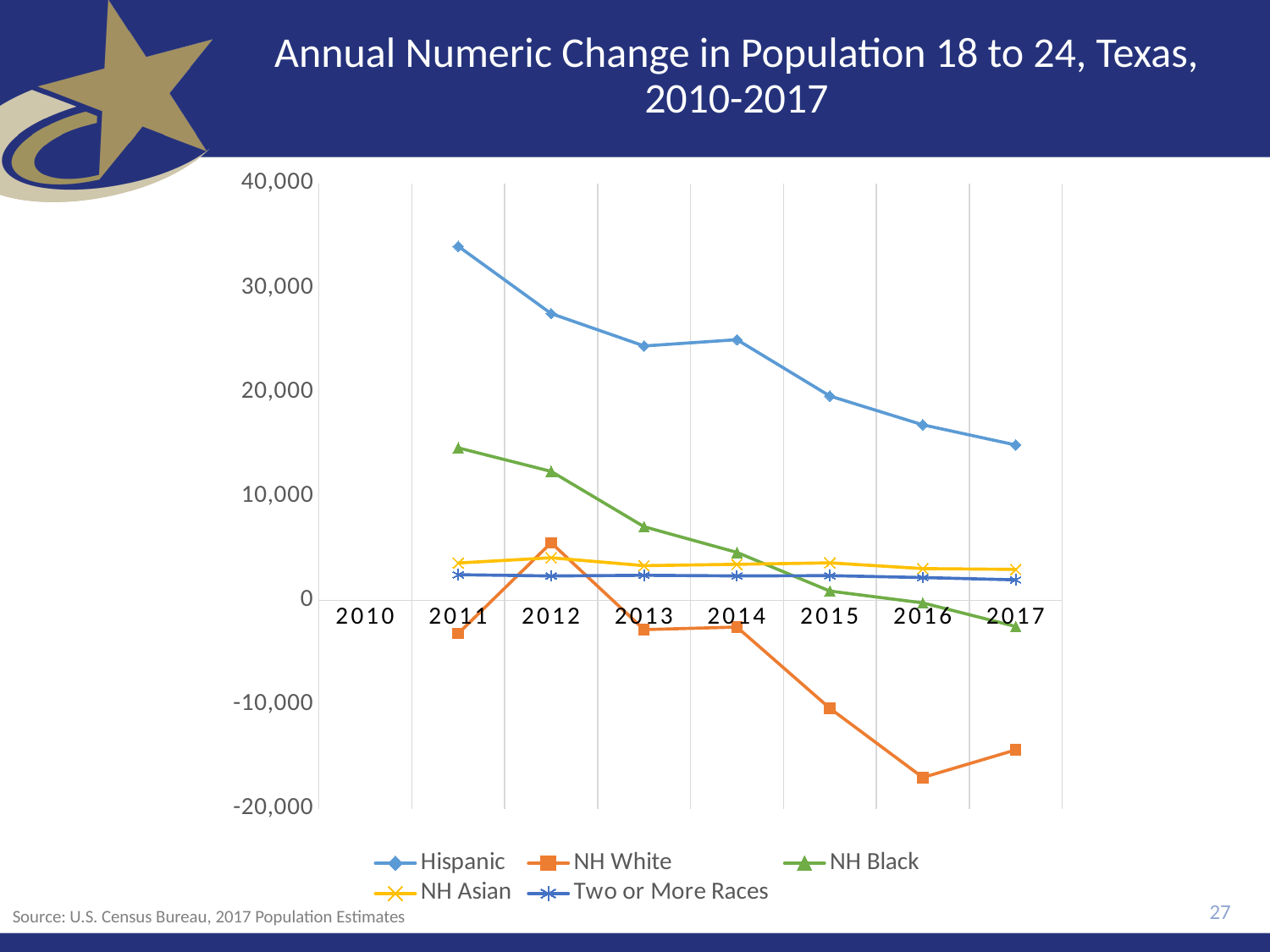
Is the value for NH Black in 2011 greater or less than 10,000? greater What kind of chart is shown on the slide? line chart How many year labels appear along the x axis? 8 Is the value for Hispanic in 2011 greater or less than 30,000? greater Does the Hispanic series rise or fall from 2011 to 2017? fall Which series has the lowest value in 2016? NH White Is the value for Hispanic in 2017 greater or less than 20,000? less Which series has the highest value in 2011? Hispanic How many series does the legend list? 5 In 2013, which is larger: the value for Hispanic or the value for NH Black? Hispanic What is the title of the chart? Annual Numeric Change in Population 18 to 24, Texas, 2010-2017